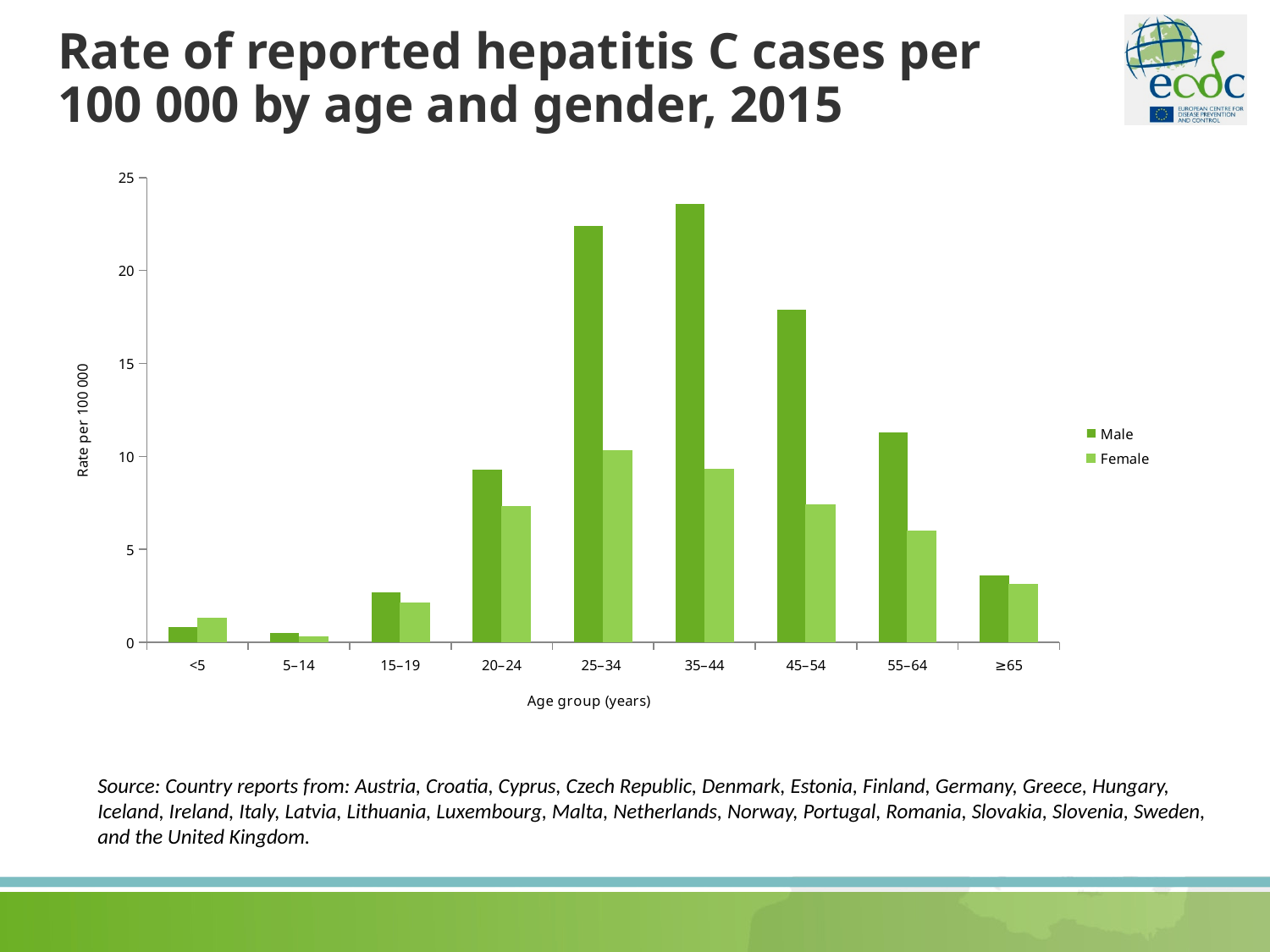
How many age groups are shown on the x axis? 9 In the 25–34 age group, which is larger, the Male rate or the Female rate? Male Which age group has the highest rate for Male? 35–44 Is the Male rate for the 35–44 age group greater or less than 20? greater Which age group has the highest rate for Female? 25–34 Which age group has the lowest rate for Male? 5–14 Is the Male rate for the ≥65 age group greater or less than 5? less What kind of chart is shown on the slide? Bar chart How many series does the legend list? 2 Do the Male rates rise or fall across the age groups from 35–44 to ≥65? Fall Is the Female rate for the 20–24 age group greater or less than 10? less